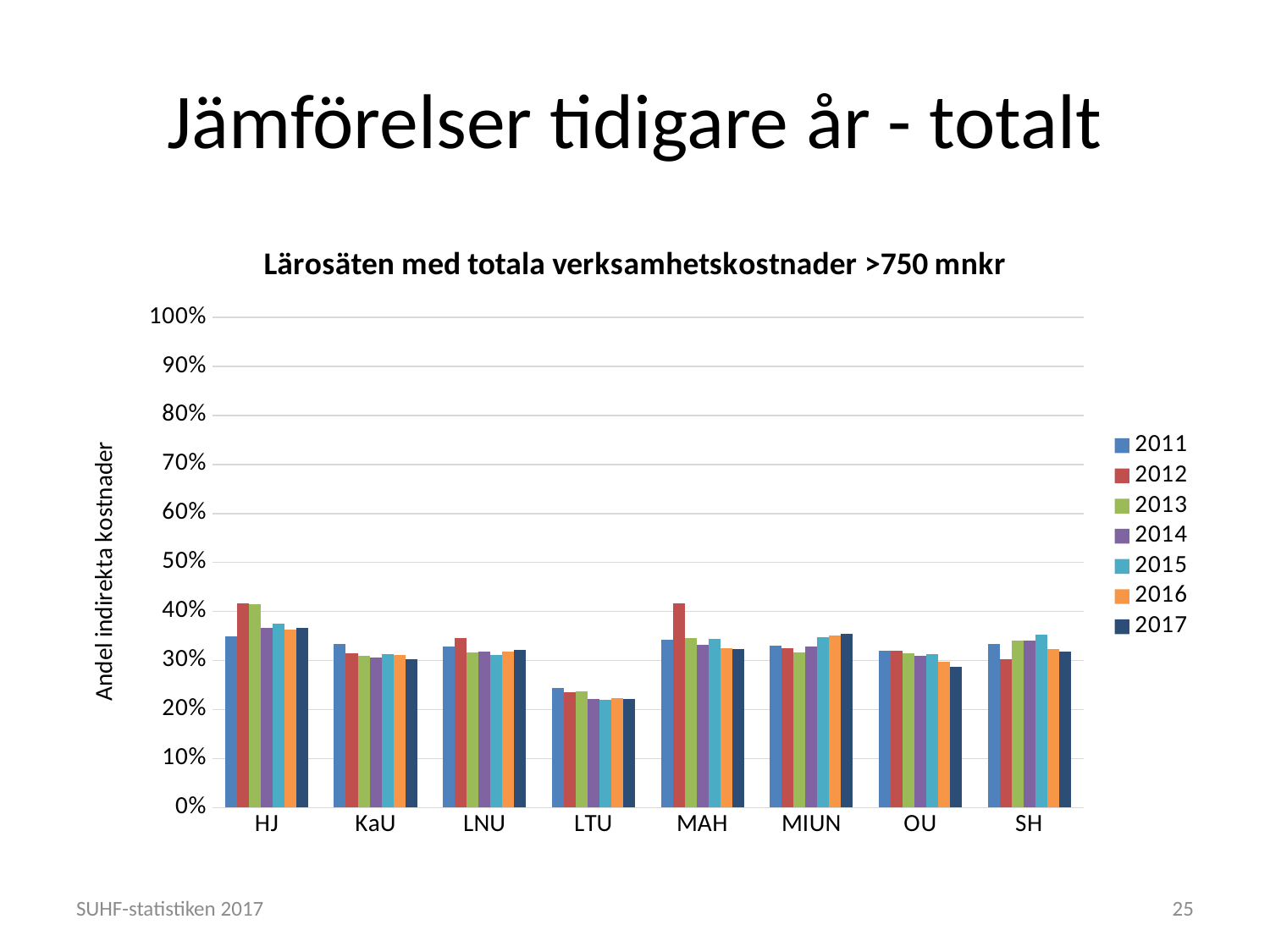
What is the title of the chart? Lärosäten med totala verksamhetskostnader >750 mnkr Is the value for LTU in 2011 greater or less than 30%? less How many institutions (categories) are shown on the x axis? 8 How many years (series) does the legend list? 7 Is the value for MAH in 2012 greater or less than 40%? greater Do the values for OU rise or fall from 2011 to 2017? fall Which is larger for MAH: the 2011 value or the 2012 value? 2012 What kind of chart is shown on the slide? bar chart Which is larger for SH: the 2012 value or the 2015 value? 2015 Which institution has the lowest values across all years? LTU What is the label on the y axis? Andel indirekta kostnader Is the value for OU in 2017 greater or less than 30%? less